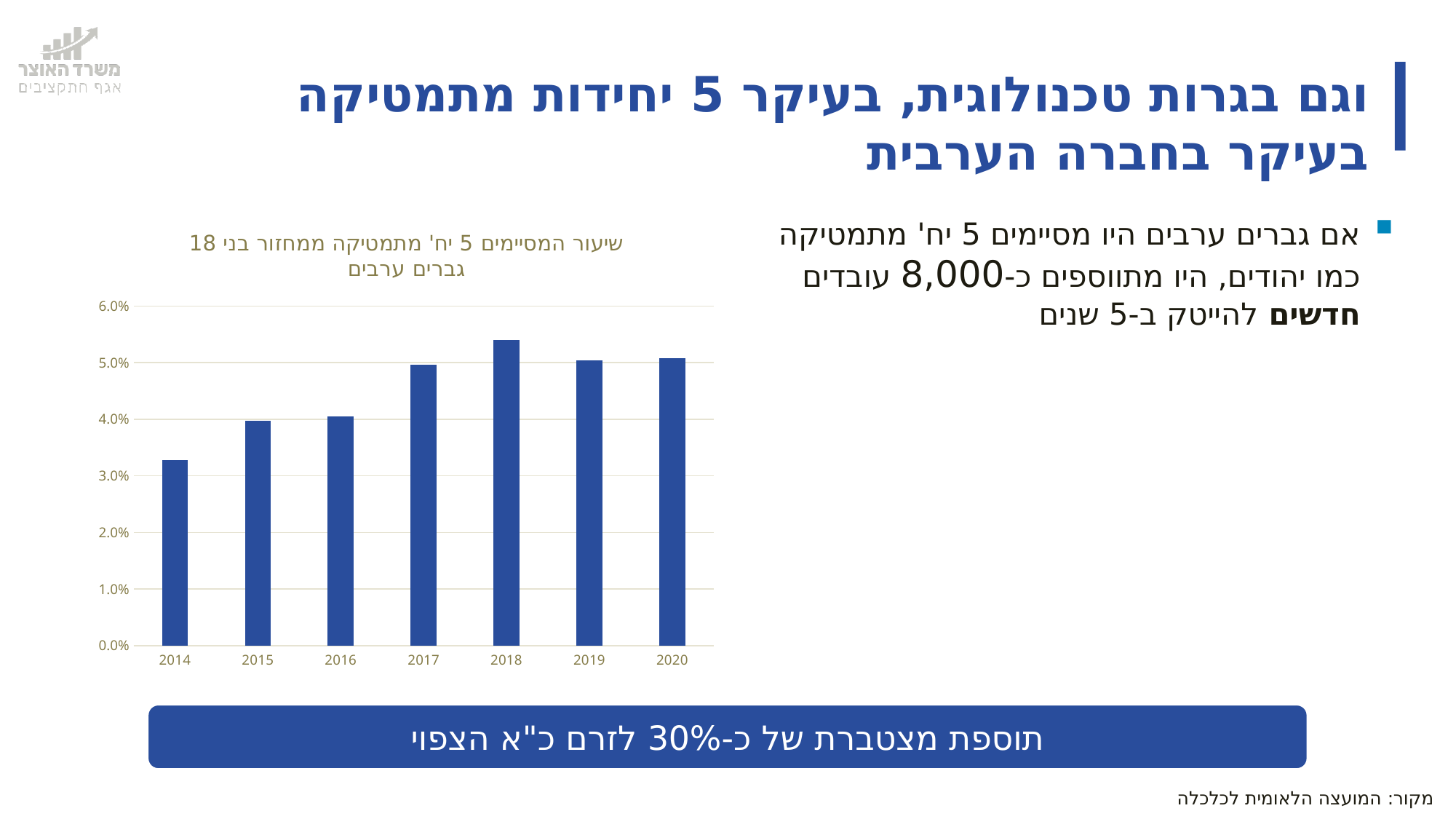
Which year has the lowest bar in the chart? 2014 Which is larger, the value for 2014 or the value for 2017? 2017 How many years are shown on the x axis of the chart? 7 Do the values rise or fall from 2014 to 2018? rise Which year has the highest bar in the chart? 2018 Is the value for 2018 greater or less than 5.0%? greater Is the value for 2014 greater or less than 4.0%? less What kind of chart is shown on the slide? bar chart What is the title of the chart? שיעור המסיימים 5 יח' מתמטיקה ממחזור בני 18 גברים ערבים Which is larger, the value for 2015 or the value for 2018? 2018 Is the value for 2016 greater or less than 5.0%? less